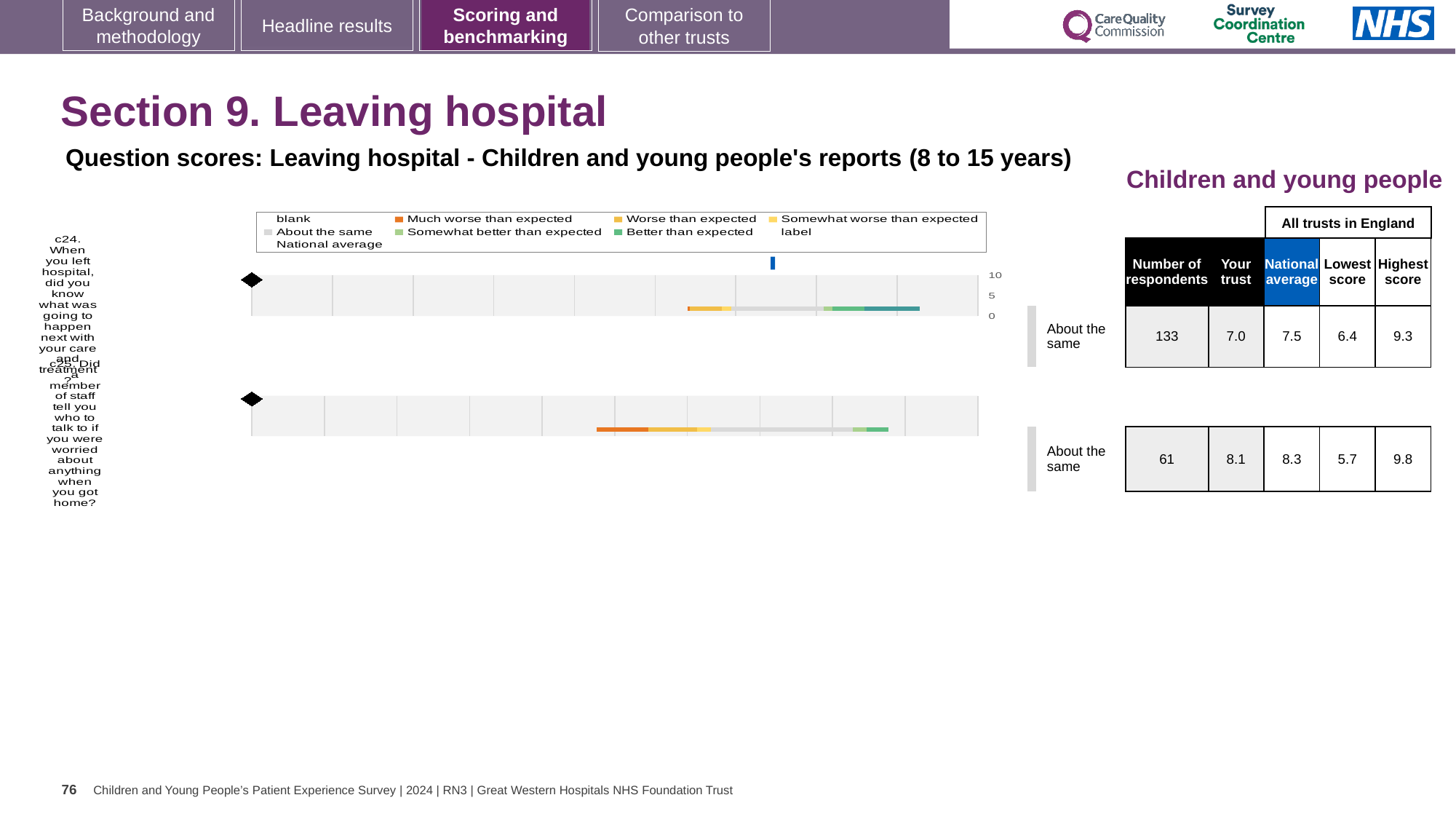
What is the difference between the national average and the 'Your trust' score for question c24? 0.5 According to the table beside the chart, what is the highest score among all trusts in England for question c25? 9.8 How many survey questions (bars) are plotted in the chart? 2 Which question has the higher 'Your trust' score, c24 or c25? c25 What is the benchmark rating shown beside the bar for question c25? About the same What is the difference between the highest and lowest scores for question c25? 4.1 According to the table beside the chart, what is the national average for question c25? 8.3 According to the table beside the chart, what is the 'Your trust' score for question c24? 7.0 What kind of chart is shown on the slide? bar chart Which legend entry is shown in orange? Much worse than expected What is the benchmark rating shown beside the bar for question c24? About the same According to the table beside the chart, how many respondents answered question c24? 133